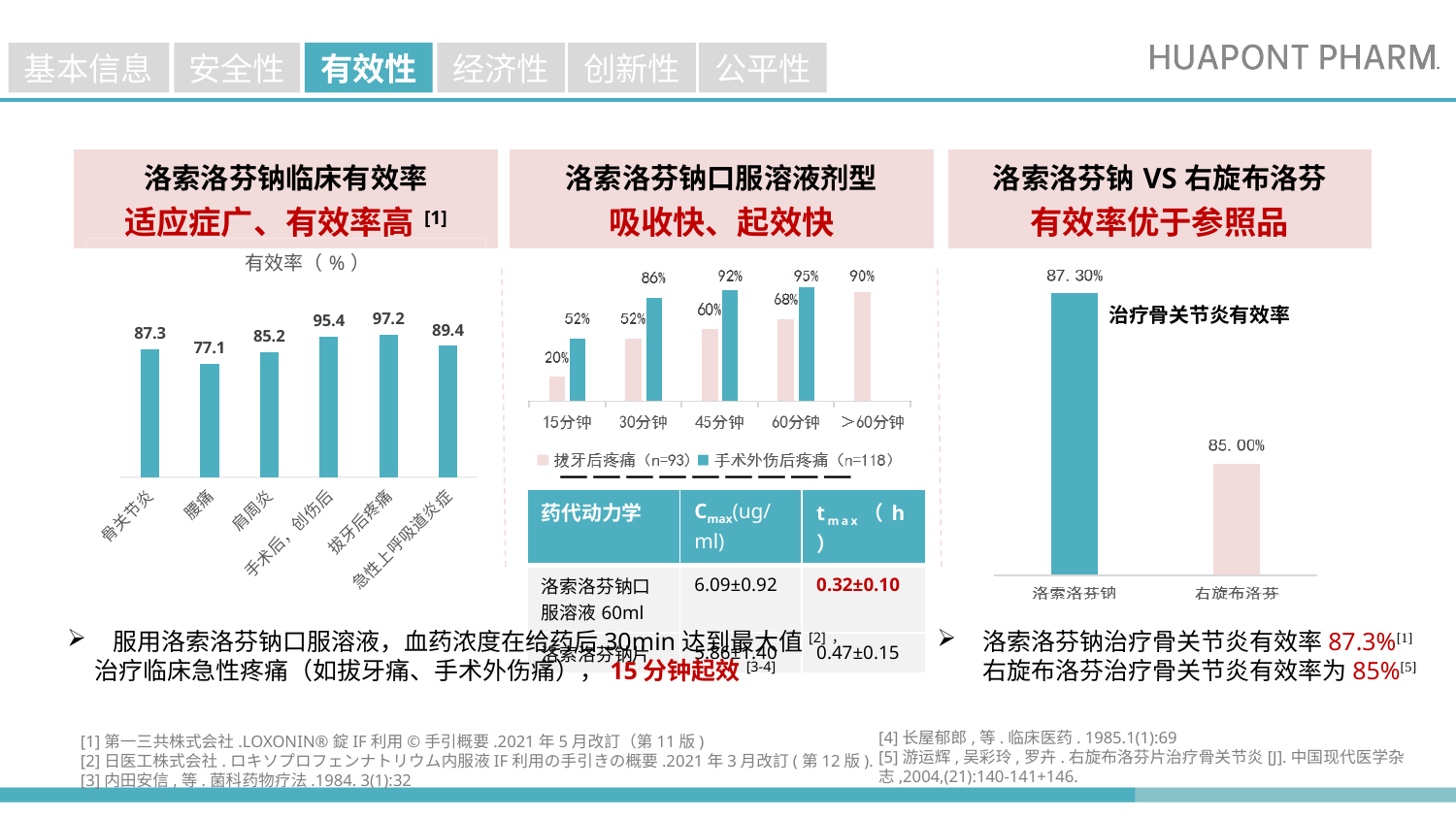
In the left chart (洛索洛芬钠临床有效率), what is the difference between the values for 拔牙后疼痛 and 腰痛? 20.1 In the left chart (洛索洛芬钠临床有效率), how many categories are shown? 6 In the middle chart (洛索洛芬钠口服溶液剂型), what is the value for 手术外伤后疼痛 (n=118) at 45分钟? 92% In the right chart (洛索洛芬钠 VS 右旋布洛芬), what is the value for 右旋布洛芬? 85.00% In the left chart (洛索洛芬钠临床有效率), which category has the lowest value? 腰痛 In the middle chart (洛索洛芬钠口服溶液剂型), do the values for 拔牙后疼痛 (n=93) rise or fall from 15分钟 to >60分钟? rise In the middle chart (洛索洛芬钠口服溶液剂型), how many series does the legend list? 2 In the left chart (洛索洛芬钠临床有效率), what is the value for 骨关节炎? 87.3 In the middle chart (洛索洛芬钠口服溶液剂型), what is the value for 拔牙后疼痛 (n=93) at 15分钟? 20% What kind of chart is the right chart (洛索洛芬钠 VS 右旋布洛芬)? bar chart In the right chart (洛索洛芬钠 VS 右旋布洛芬), which is larger, 洛索洛芬钠 or 右旋布洛芬? 洛索洛芬钠 In the left chart (洛索洛芬钠临床有效率), which category has the highest value? 拔牙后疼痛